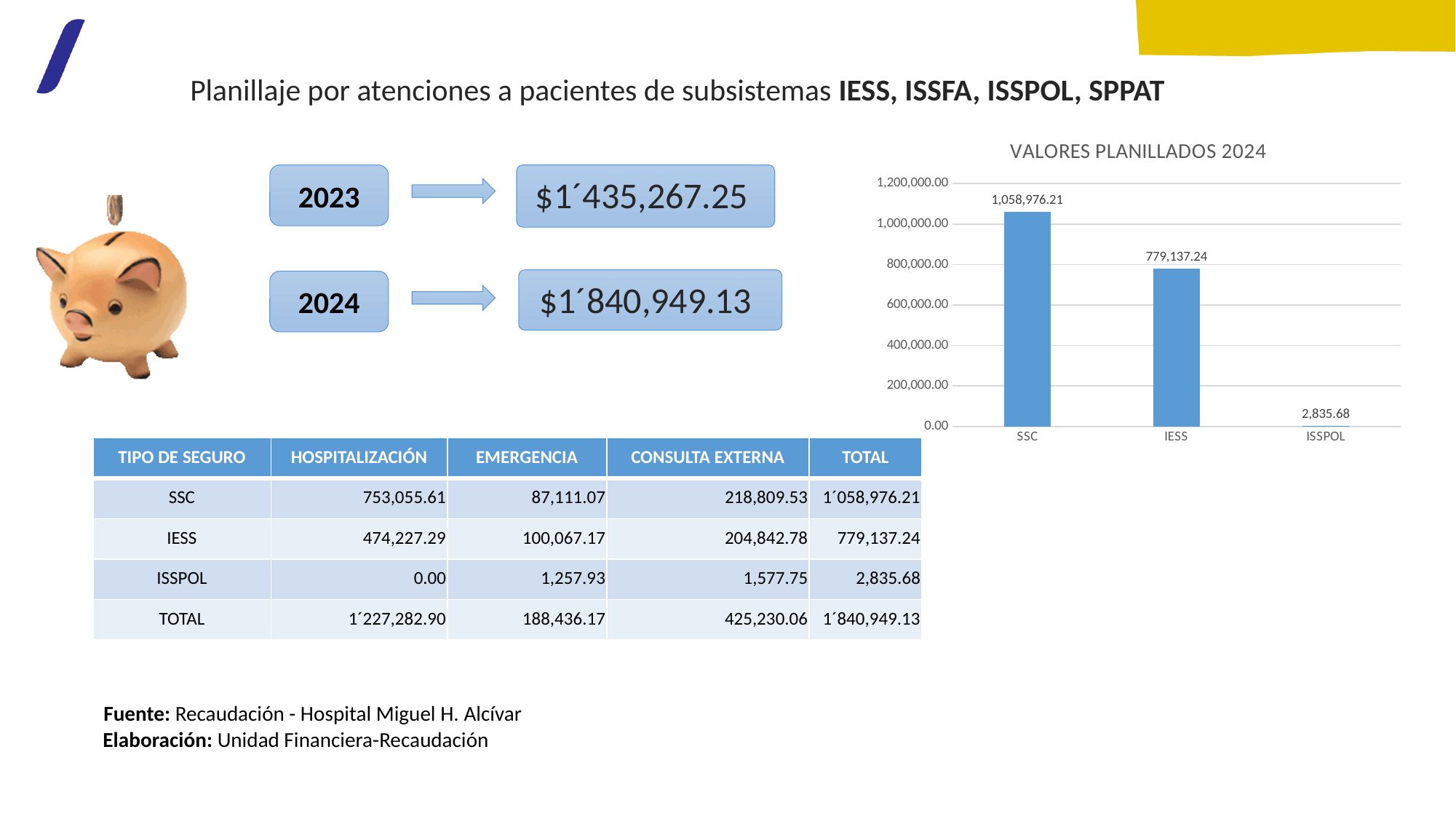
What is the value for IESS in the VALORES PLANILLADOS 2024 chart? 779,137.24 How many categories are shown in the VALORES PLANILLADOS 2024 chart? 3 What is the title of the chart on the slide? VALORES PLANILLADOS 2024 What is the value for ISSPOL in the VALORES PLANILLADOS 2024 chart? 2,835.68 Which category has the lowest value in the VALORES PLANILLADOS 2024 chart? ISSPOL What is the value for SSC in the VALORES PLANILLADOS 2024 chart? 1,058,976.21 What is the difference between the SSC and IESS values in the VALORES PLANILLADOS 2024 chart? 279,838.97 Is the value for IESS in the VALORES PLANILLADOS 2024 chart greater or less than 800,000.00? less Is the value for SSC in the VALORES PLANILLADOS 2024 chart greater or less than 1,000,000.00? greater In the VALORES PLANILLADOS 2024 chart, which is larger, the value for IESS or the value for ISSPOL? IESS What kind of chart is VALORES PLANILLADOS 2024? bar chart Which category has the highest value in the VALORES PLANILLADOS 2024 chart? SSC